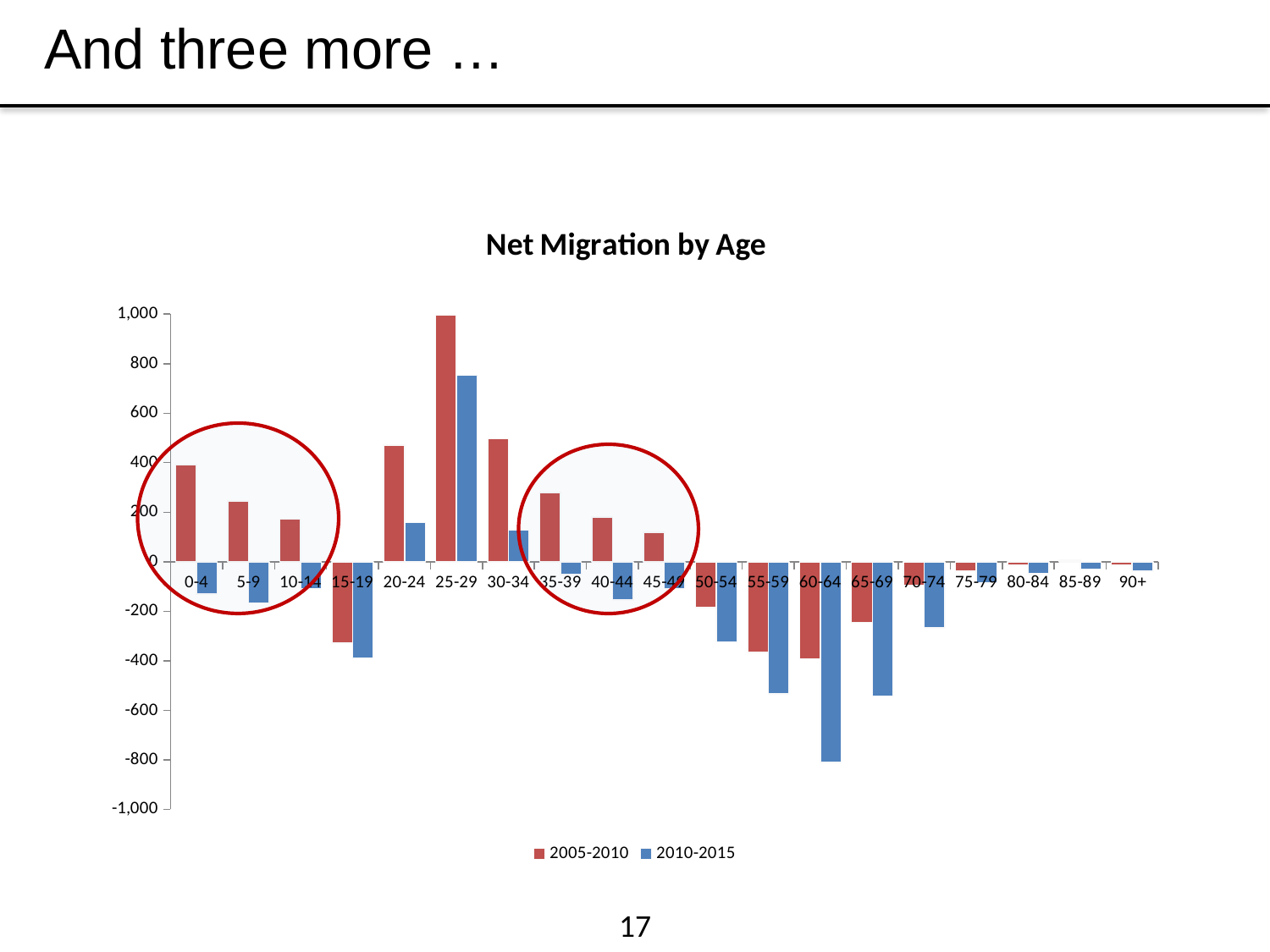
For the 25-29 age group, which series has the larger value, 2005-2010 or 2010-2015? 2005-2010 Is the 2010-2015 value for 25-29 greater or less than 800? less Is the 2010-2015 value for 55-59 greater or less than -400? less What type of chart is shown on the slide? bar chart Is the 2005-2010 value for 25-29 greater or less than 800? greater How many series does the legend list? 2 What is the title of the chart? Net Migration by Age For the 2005-2010 series, which is larger, the value for 0-4 or the value for 5-9? 0-4 Which age group has the lowest value for the 2010-2015 series? 60-64 How many age categories are shown on the x axis? 19 Which age group has the highest value for the 2005-2010 series? 25-29 Which colour represents the 2010-2015 series? blue